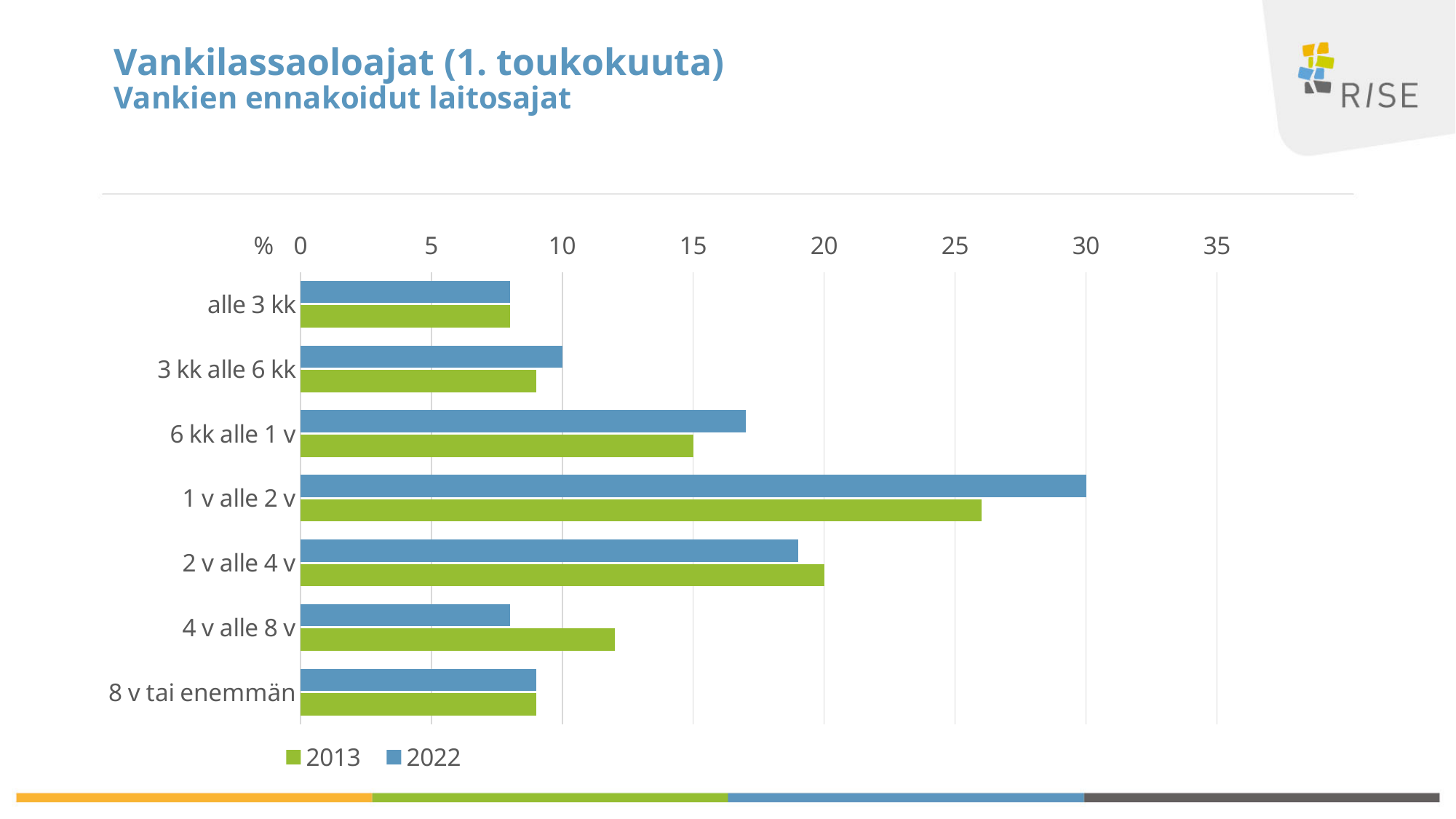
How many series does the legend list? 2 For '4 v alle 8 v', which series has the larger value, 2013 or 2022? 2013 What kind of chart is shown on the slide? bar chart Which series is shown in green in the legend? 2013 How many categories are shown on the chart? 7 What is the 2022 value for '1 v alle 2 v'? 30 What is the 2013 value for '2 v alle 4 v'? 20 What is the 2022 value for '3 kk alle 6 kk'? 10 What is the difference between the 2022 value for '1 v alle 2 v' and the 2013 value for '6 kk alle 1 v'? 15 Is the 2013 value for '1 v alle 2 v' greater or less than 25? greater What is the 2013 value for '6 kk alle 1 v'? 15 Which category has the highest 2022 value? 1 v alle 2 v